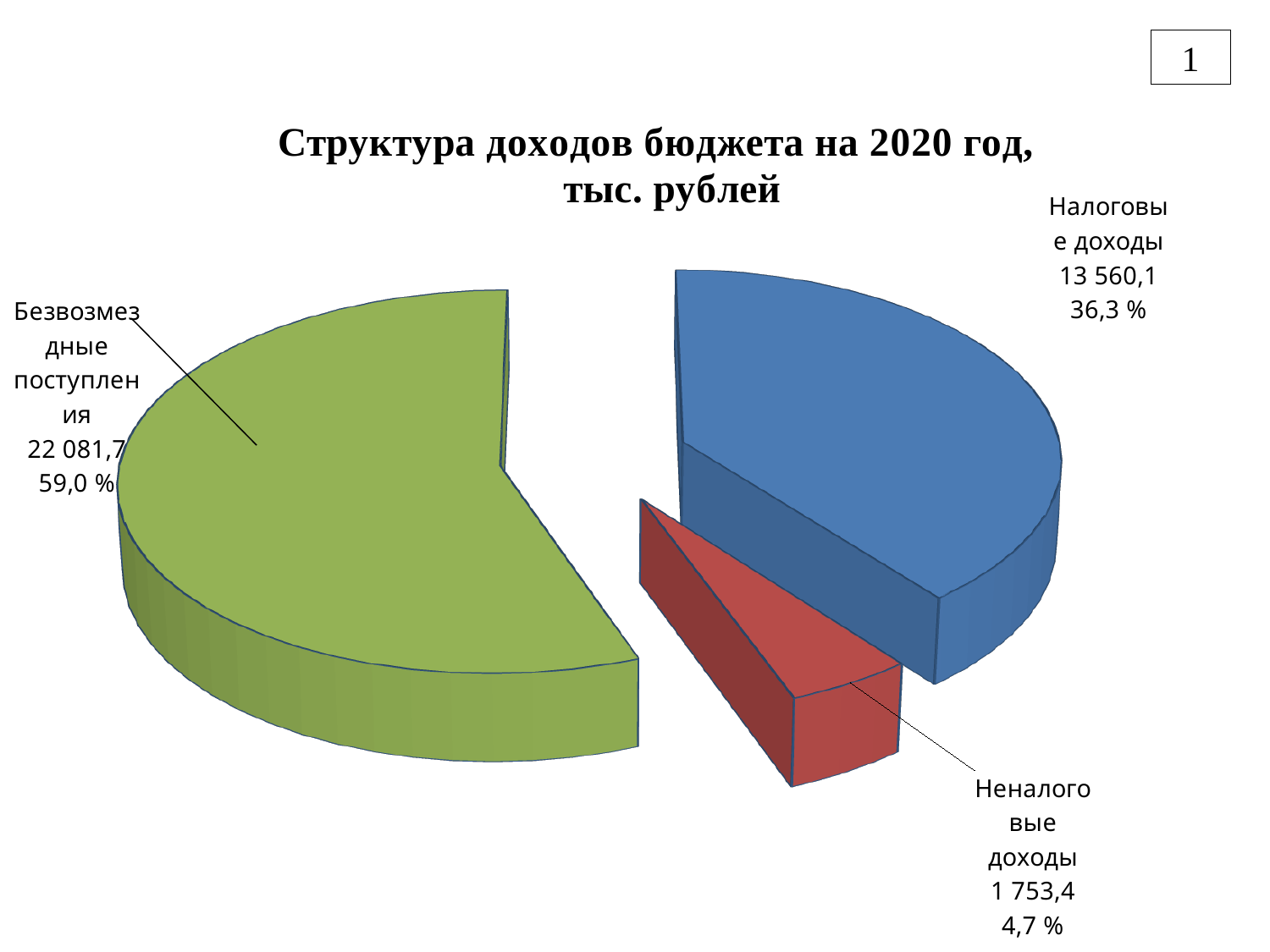
What kind of chart is shown on the slide? Pie chart What is the value for Налоговые доходы? 13 560,1 What share of the pie does Неналоговые доходы represent? 4,7 % What is the difference between the values for Безвозмездные поступления and Налоговые доходы? 8 521,6 Which category has the largest slice of the pie? Безвозмездные поступления Which category has the smallest slice of the pie? Неналоговые доходы What is the value for Неналоговые доходы? 1 753,4 What is the title of the chart? Структура доходов бюджета на 2020 год, тыс. рублей What is the value for Безвозмездные поступления? 22 081,7 Which is larger, the value for Налоговые доходы or the value for Неналоговые доходы? Налоговые доходы What share of the pie does Налоговые доходы represent? 36,3 % How many categories are shown in the pie chart? 3